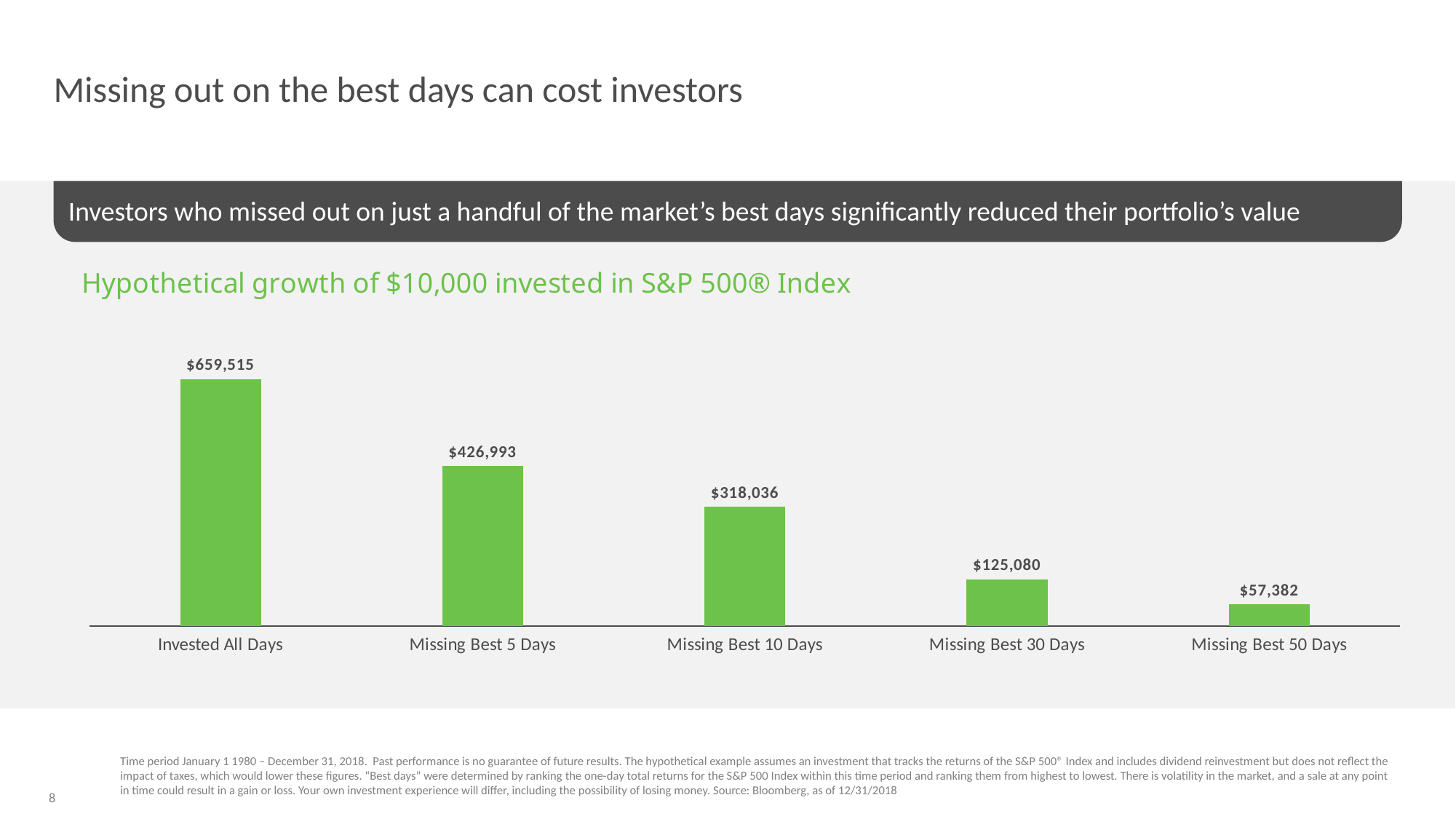
Which is larger, Missing Best 5 Days or Missing Best 10 Days? Missing Best 5 Days Which category has the highest value? Invested All Days What is the difference between Missing Best 30 Days and Missing Best 50 Days? $67,698 How many categories are shown on the chart? 5 Which category has the lowest value? Missing Best 50 Days What is the title of the chart? Hypothetical growth of $10,000 invested in S&P 500® Index What is the value for Invested All Days? $659,515 What kind of chart is shown? Bar chart What is the value for Missing Best 50 Days? $57,382 What is the difference between Invested All Days and Missing Best 5 Days? $232,522 What is the value for Missing Best 10 Days? $318,036 Do the values rise or fall from left to right along the x axis? Fall